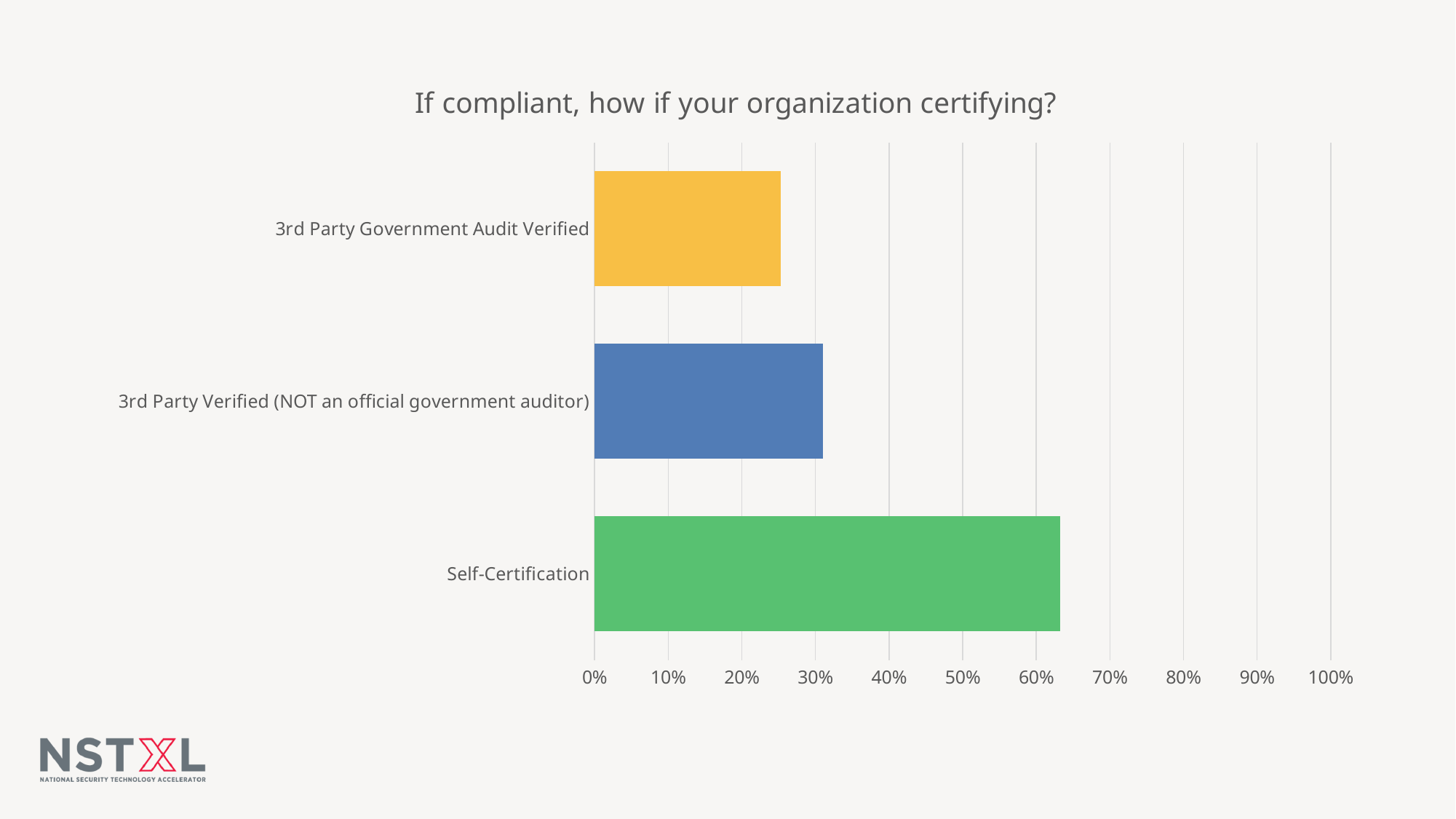
Is the value for Self-Certification greater or less than 60%? greater How many categories are plotted in the chart? 3 Is the value for 3rd Party Government Audit Verified greater or less than 30%? less What is the title of the chart? If compliant, how if your organization certifying? Is the value for 3rd Party Government Audit Verified greater or less than 20%? greater Which category has the lowest value? 3rd Party Government Audit Verified Which is larger: the value for Self-Certification or the value for 3rd Party Verified (NOT an official government auditor)? Self-Certification Which category has the highest value? Self-Certification Which is larger: the value for 3rd Party Verified (NOT an official government auditor) or the value for 3rd Party Government Audit Verified? 3rd Party Verified (NOT an official government auditor) What kind of chart is shown on the slide? bar chart